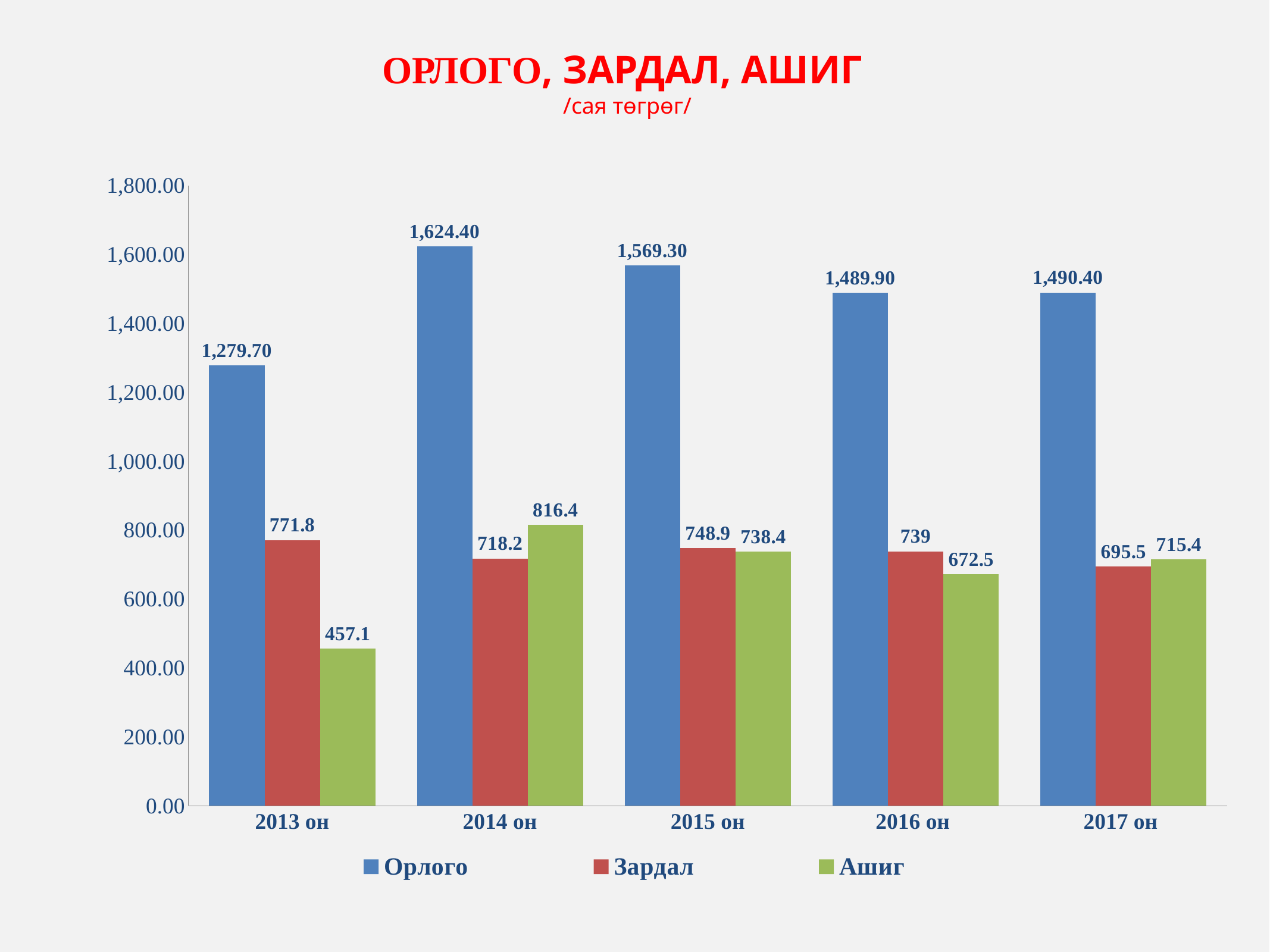
What is the value of Зардал for 2017 он? 695.5 How many years are shown on the x axis? 5 In which year is Орлого the highest? 2014 он How many series does the legend list? 3 What is the value of Орлого for 2014 он? 1,624.40 What is the value of Ашиг for 2013 он? 457.1 What kind of chart is shown on the slide? Bar chart What is the difference between Зардал in 2013 он and Зардал in 2017 он? 76.3 Does Зардал rise or fall from 2015 он to 2017 он? Fall By how much did Орлого increase from 2013 он to 2014 он? 344.70 In 2015 он, which is larger: Зардал or Ашиг? Зардал In which year is Ашиг the lowest? 2013 он